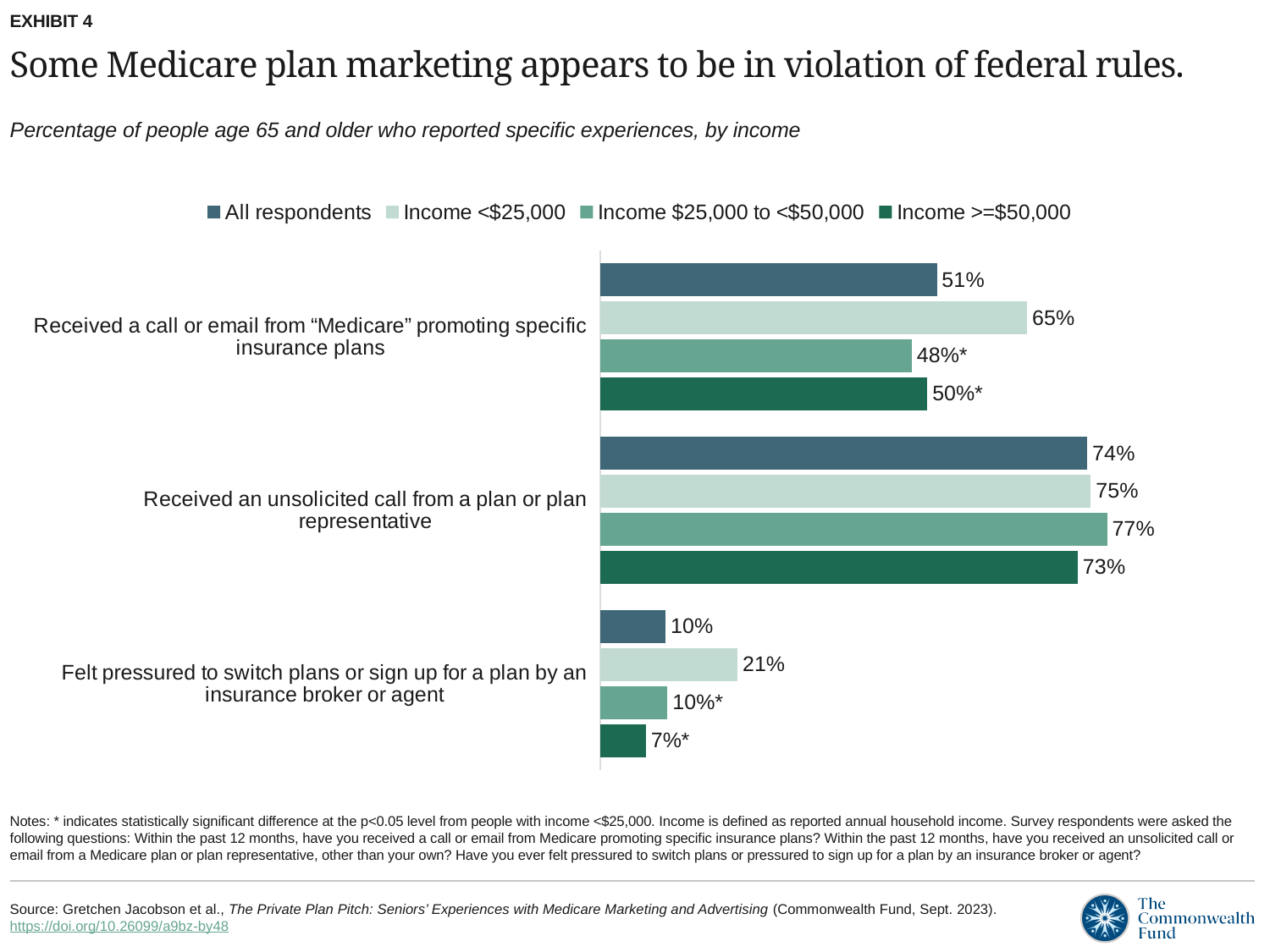
What percentage of people with income $25,000 to <$50,000 received an unsolicited call from a plan or plan representative? 77% What type of chart is shown on the slide? Bar chart How many categories (experiences) are shown on the chart? 3 What percentage of people with income <$25,000 felt pressured to switch plans or sign up for a plan by an insurance broker or agent? 21% Which experience has the highest value for All respondents? Received an unsolicited call from a plan or plan representative What is the difference between the Income <$25,000 value and the All respondents value for feeling pressured to switch plans or sign up for a plan by an insurance broker or agent? 11 percentage points What is the difference between the Income <$25,000 value and the All respondents value for receiving a call or email from "Medicare" promoting specific insurance plans? 14 percentage points How many series does the legend list? 4 Which income group has the highest value for receiving a call or email from "Medicare" promoting specific insurance plans? Income <$25,000 Which income group has the lowest value for feeling pressured to switch plans or sign up for a plan by an insurance broker or agent? Income >=$50,000 What percentage of all respondents received a call or email from "Medicare" promoting specific insurance plans? 51% For receiving an unsolicited call from a plan or plan representative, which is larger: the value for Income <$25,000 or the value for Income >=$50,000? Income <$25,000